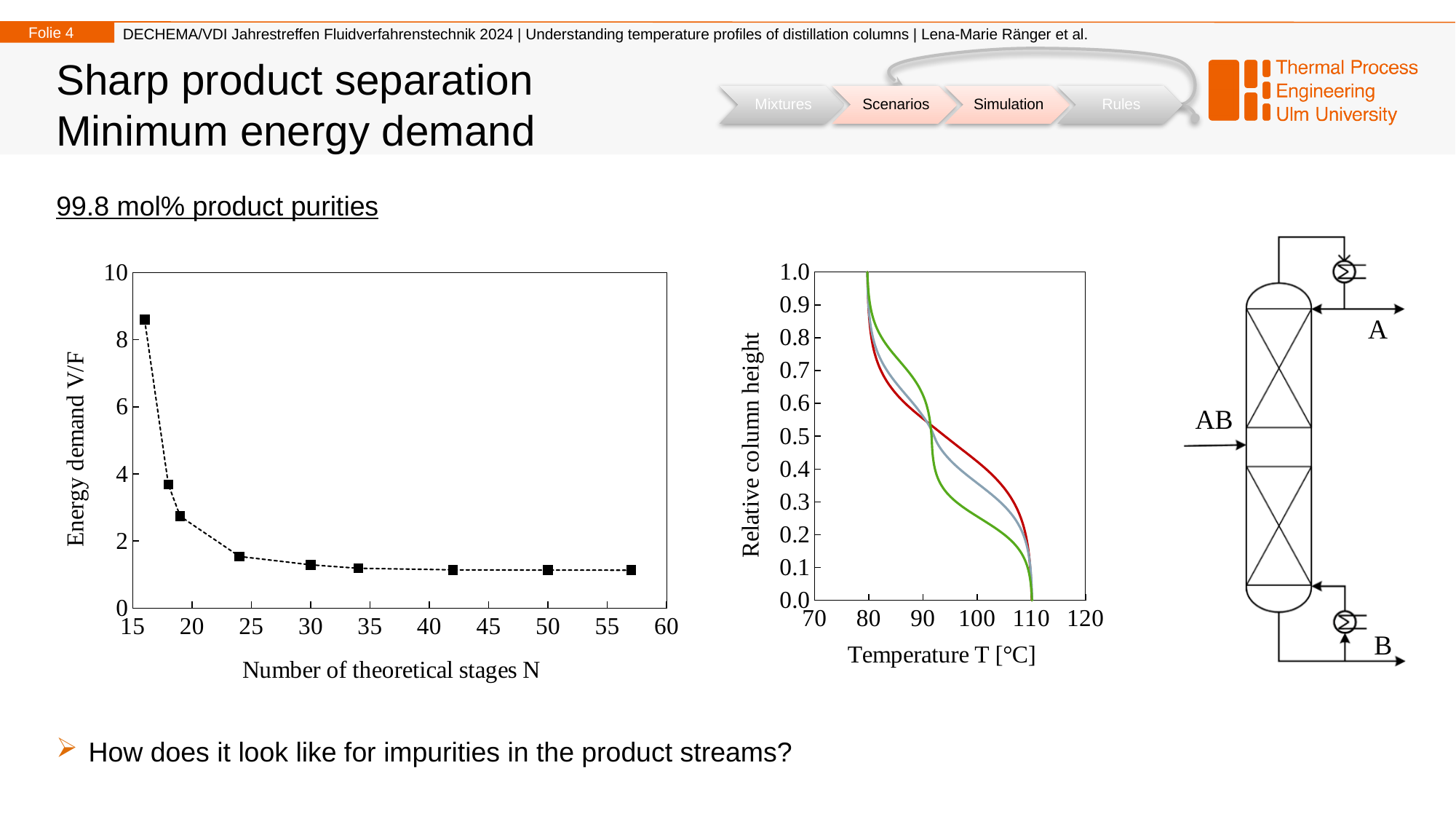
In the right chart, is the temperature at relative column height 1.0 greater or less than 90? less In the left chart, what kind of chart is it? line chart with markers In the right chart, what is the label of the y axis? Relative column height In the right chart, how many curves are plotted? 3 In the left chart, is the energy demand V/F at N = 18 greater or less than 2? greater In the left chart, is the energy demand V/F for the first point (at about N = 16) greater or less than 8? greater In the left chart, does the energy demand V/F rise or fall as the number of theoretical stages N increases? fall In the right chart, does the temperature rise or fall as the relative column height increases? fall In the left chart, what is the label of the x axis? Number of theoretical stages N In the left chart, how many data points are plotted? 9